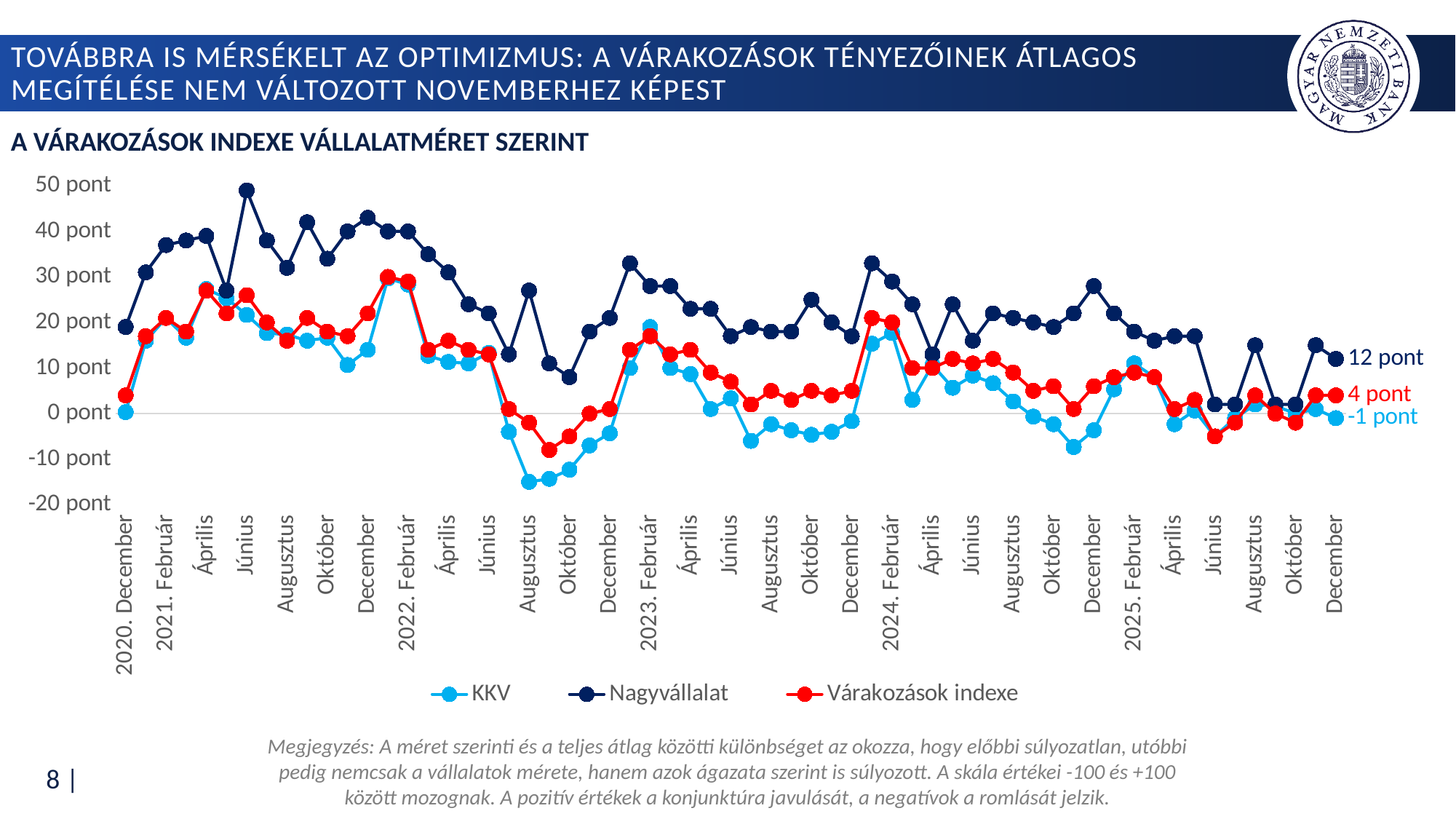
How many series does the legend list? 3 What is the title of the chart? A várakozások indexe vállalatméret szerint Does the Nagyvállalat series rise or fall between June 2021 and August 2022? fall Is the value for Nagyvállalat in June 2021 greater or less than 40 pont? greater What is the difference between the Nagyvállalat and the Várakozások indexe values in December 2025? 8 pont Is the value for KKV in August 2022 greater or less than -10 pont? less What is the value of the KKV series in December 2025? -1 pont What is the value of the Nagyvállalat series in December 2025? 12 pont Which series has the highest value in December 2025? Nagyvállalat What type of chart is shown on the slide? line chart Which series has the lowest value in December 2025? KKV What is the value of the Várakozások indexe series in December 2025? 4 pont